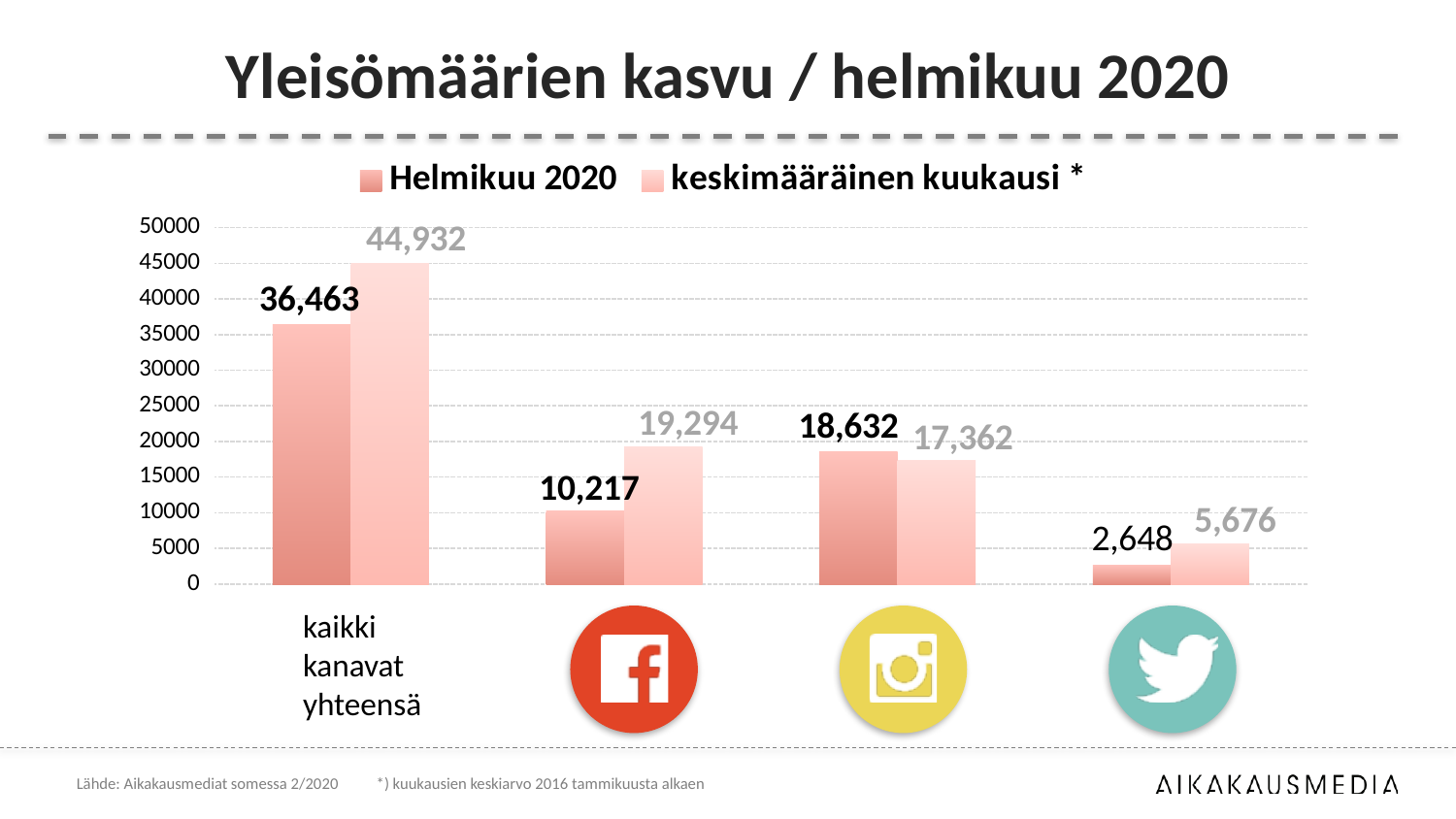
What is the Helmikuu 2020 value for the Facebook category? 10,217 What is the keskimääräinen kuukausi value for kaikki kanavat yhteensä? 44,932 What is the title of the chart slide? Yleisömäärien kasvu / helmikuu 2020 What is the keskimääräinen kuukausi value for the Instagram category? 17,362 What is the Helmikuu 2020 value for the Twitter category? 2,648 What kind of chart is shown on the slide? bar chart What is the Helmikuu 2020 value for kaikki kanavat yhteensä? 36,463 Which category has the lowest Helmikuu 2020 value? Twitter For the Instagram category, which is larger: the Helmikuu 2020 value or the keskimääräinen kuukausi value? Helmikuu 2020 What is the difference between the keskimääräinen kuukausi value and the Helmikuu 2020 value for the Facebook category? 9,077 How many series does the legend list? 2 How many categories are shown on the x axis? 4